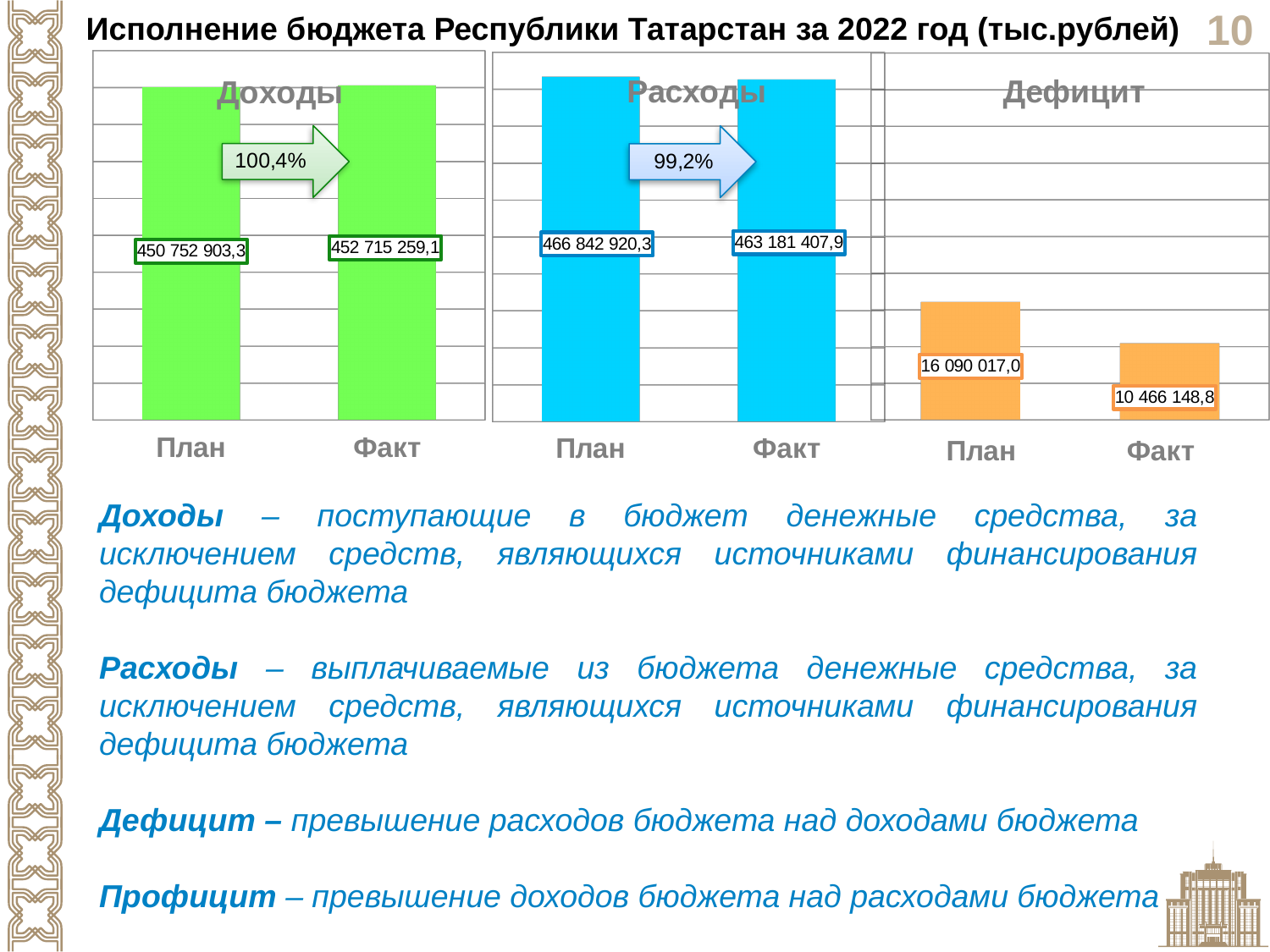
In the Доходы chart, what is the value for План? 450 752 903,3 What percentage is shown on the arrow in the Расходы chart? 99,2% In the Дефицит chart, what is the value for План? 16 090 017,0 In the Дефицит chart, what is the value for Факт? 10 466 148,8 In the Дефицит chart, which category is higher, План or Факт? План In the Доходы chart, what is the value for Факт? 452 715 259,1 In the Расходы chart, which category has the lower value? Факт In the Расходы chart, what is the value for Факт? 463 181 407,9 In the Доходы chart, what is the difference between Факт and План? 1 962 355,8 In the Расходы chart, what is the value for План? 466 842 920,3 In the Дефицит chart, what is the difference between План and Факт? 5 623 868,2 What type of chart is the Дефицит chart? Bar chart